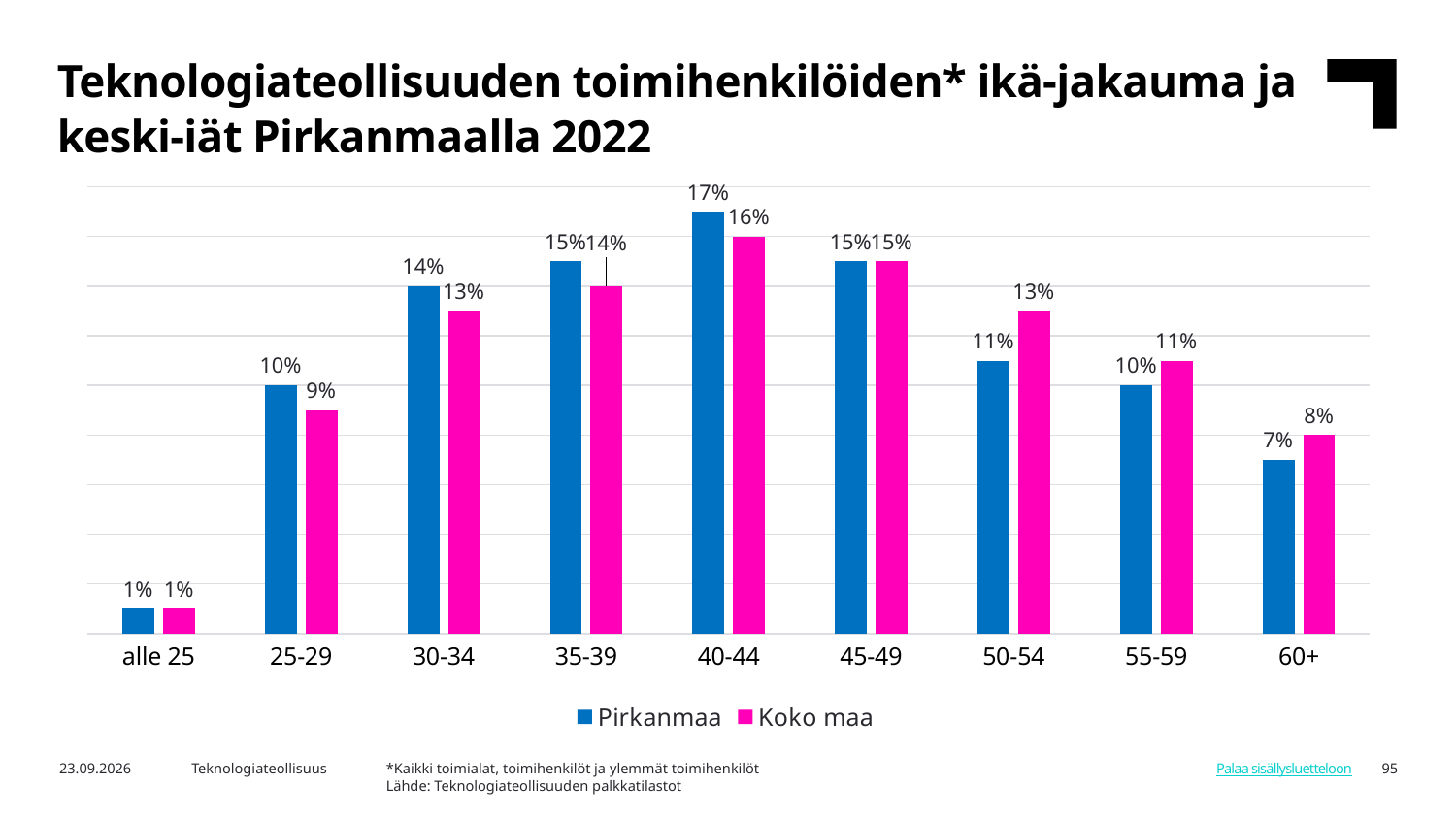
How many series does the legend list? 2 In the 55-59 age group, which series has the larger value, Pirkanmaa or Koko maa? Koko maa What is the value for Pirkanmaa in the 40-44 age group? 17% How many age groups are shown on the x axis? 9 What is the value for Pirkanmaa in the 60+ age group? 7% What kind of chart is shown on the slide? Bar chart What is the difference between the Pirkanmaa values for the 40-44 and 60+ age groups? 10% What is the value for Koko maa in the 50-54 age group? 13% What is the difference between the Pirkanmaa and Koko maa values in the 50-54 age group? 2% In the 25-29 age group, which series has the larger value, Pirkanmaa or Koko maa? Pirkanmaa Which age group has the highest value for Koko maa? 40-44 Which age group has the lowest value for Pirkanmaa? alle 25